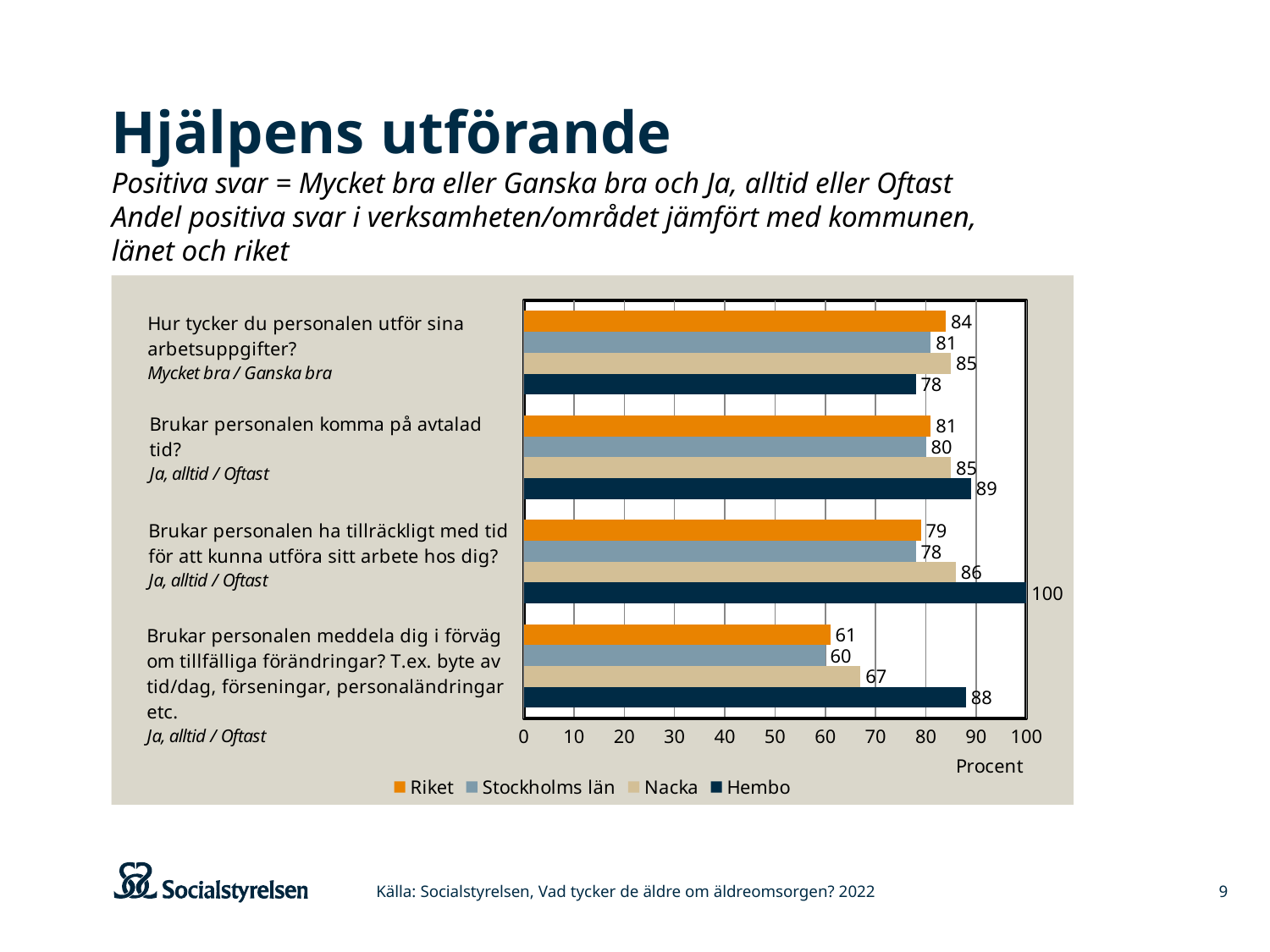
What is the label of the horizontal axis? Procent What is the value for Hembo on the question "Brukar personalen ha tillräckligt med tid för att kunna utföra sitt arbete hos dig?"? 100 What kind of chart is shown on the slide? Bar chart How many series does the legend list? 4 Which series has the lowest value on the question "Brukar personalen meddela dig i förväg om tillfälliga förändringar?"? Stockholms län Which is larger on the question "Hur tycker du personalen utför sina arbetsuppgifter?": Nacka or Hembo? Nacka What is the value for Nacka on the question "Brukar personalen meddela dig i förväg om tillfälliga förändringar?"? 67 What is the difference between Hembo and Riket on the question "Brukar personalen meddela dig i förväg om tillfälliga förändringar?"? 27 How many question categories are shown on the chart? 4 What is the value for Stockholms län on the question "Brukar personalen komma på avtalad tid?"? 80 What is the value for Riket on the question "Hur tycker du personalen utför sina arbetsuppgifter?"? 84 Which series has the highest value on the question "Brukar personalen komma på avtalad tid?"? Hembo